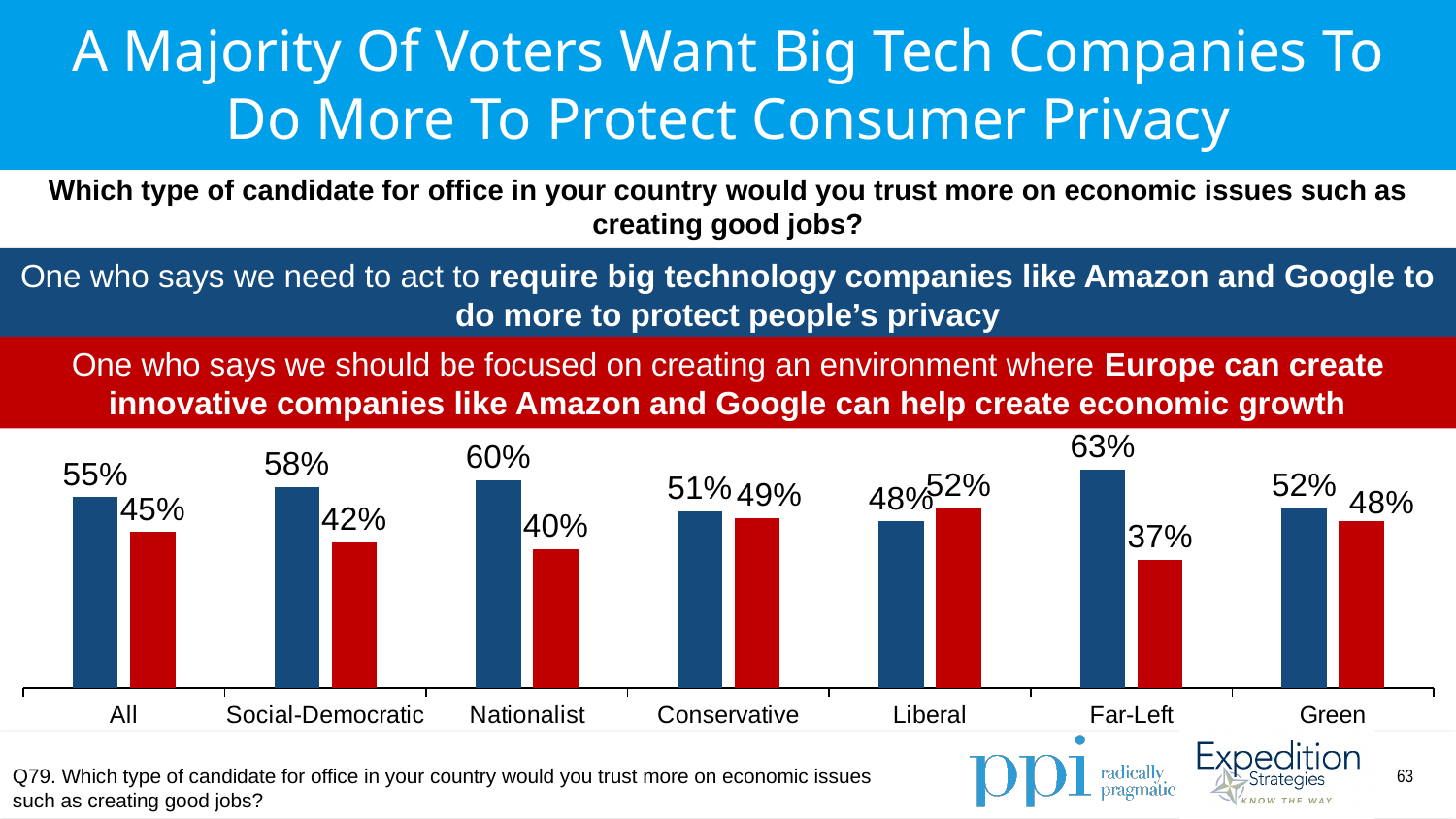
How many voter categories are shown on the x axis? 7 What is the difference between the blue and red bars for Social-Democratic voters? 16 percentage points For Liberal voters, which bar is larger, the blue or the red? Red Which category has the lowest red bar value? Far-Left Which category has the highest blue bar value? Far-Left What type of chart is shown on the slide? Bar chart What is the value of the blue bar for Nationalist voters? 60% What is the value of the red bar for Far-Left voters? 37% Which colour represents the candidate who says Europe should create innovative companies to help create economic growth? Red What percentage of All voters trust the candidate who says big tech companies should do more to protect privacy (blue bar)? 55% What is the total of the blue and red bars for Green voters? 100% How many data series are plotted in the chart? 2